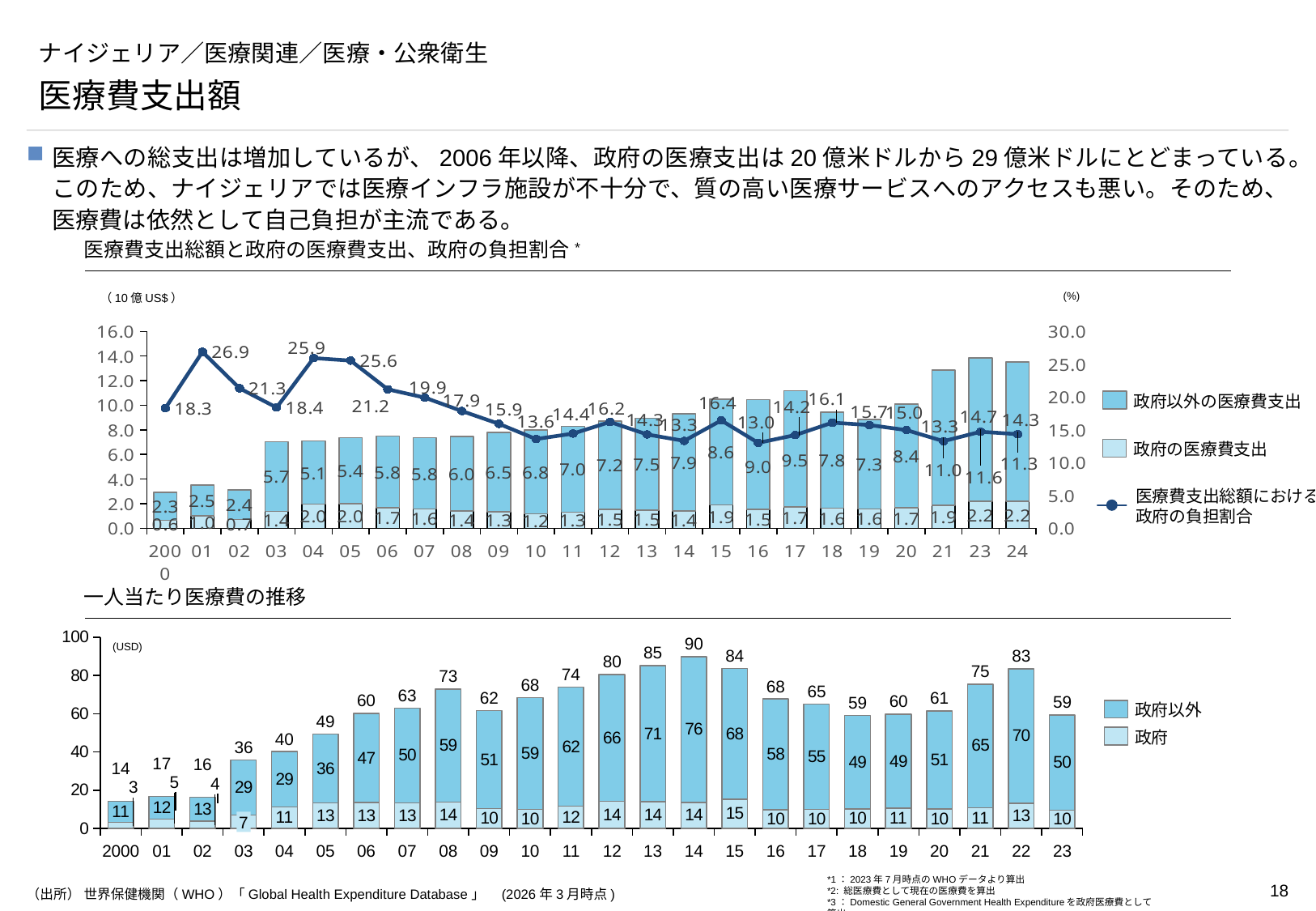
In the top chart, what is the government share of total health expenditure (政府の負担割合) in 2001? 26.9 How many years are shown on the x axis of the bottom chart (一人当たり医療費の推移)? 24 In the top chart, which is larger: the 政府以外の医療費支出 value for 2021 or for 2023? 2023 (11.6) In the top chart, what is the total of the stacked bar for 2024 (政府以外 plus 政府)? 13.5 In the bottom chart (一人当たり医療費の推移), what is the difference between the total for 2014 and the total for 2000? 76 How many series does the legend of the top chart list? 3 In the top chart, in which year is the government share line (政府の負担割合) at its lowest? 2016 In the bottom chart (一人当たり医療費の推移), what is the 政府 (government) value for 2015? 15 In the bottom chart (一人当たり医療費の推移), what is the total per-capita health expenditure shown for 2014? 90 What kind of chart is the bottom chart (一人当たり医療費の推移)? Stacked bar chart In the bottom chart (一人当たり医療費の推移), which year has the highest total per-capita health expenditure? 2014 In the top chart, what is the 政府以外の医療費支出 value for 2017? 9.5